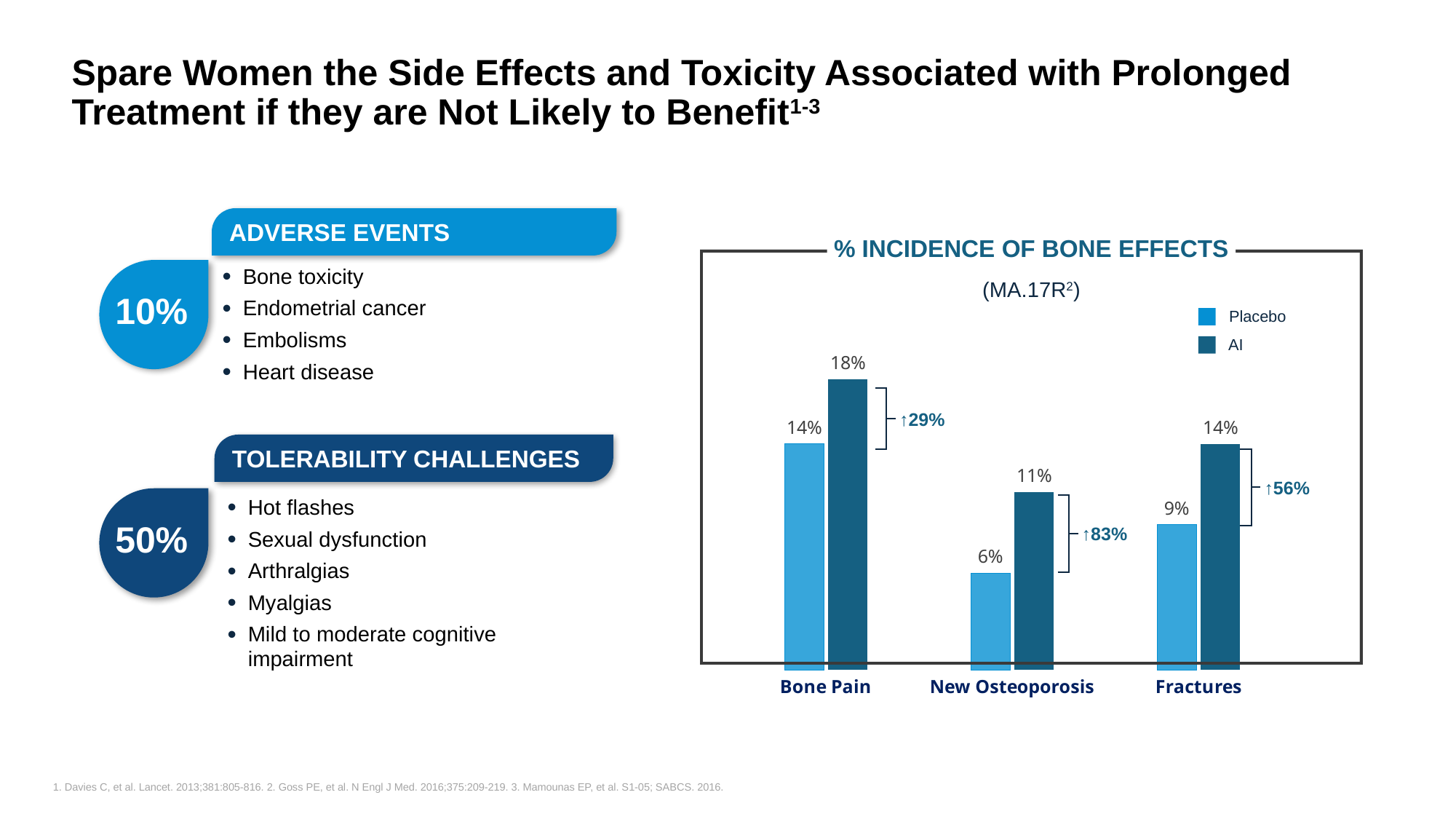
How many series does the legend list? 2 Which category has the highest AI value? Bone Pain What is the Placebo value for New Osteoporosis? 6% What kind of chart is shown? Bar chart What is the Placebo value for Bone Pain? 14% How many categories are shown on the x axis? 3 What is the AI value for Fractures? 14% Which category has the lowest Placebo value? New Osteoporosis What is the AI value for Bone Pain? 18% What is the title of the chart? % INCIDENCE OF BONE EFFECTS What is the difference between the AI and Placebo values for New Osteoporosis? 5% Which is larger for Fractures, the Placebo value or the AI value? AI